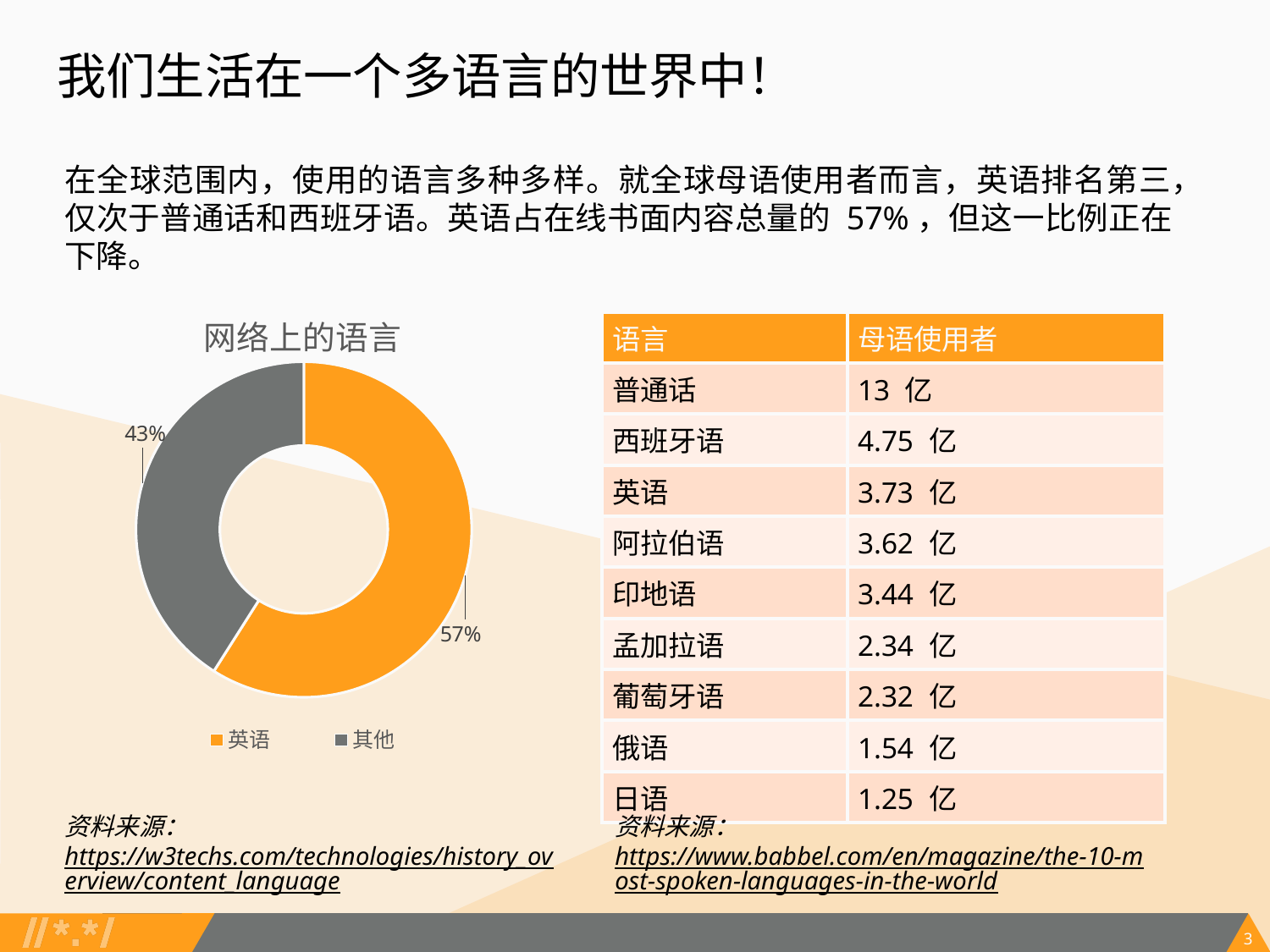
How many slices does the chart have? 2 Is the share for 其他 greater or less than 50%? less Which slice of the chart is the smallest? 其他 What share of the chart does 其他 represent? 43% What share of the chart does 英语 represent? 57% How many entries does the chart's legend list? 2 Which is larger in the chart, 英语 or 其他? 英语 What is the title of the chart? 网络上的语言 What colour is the 英语 slice in the chart? Orange Which slice of the chart is the largest? 英语 What is the difference in percentage points between the 英语 slice and the 其他 slice? 14 What kind of chart is shown on the slide? Doughnut chart